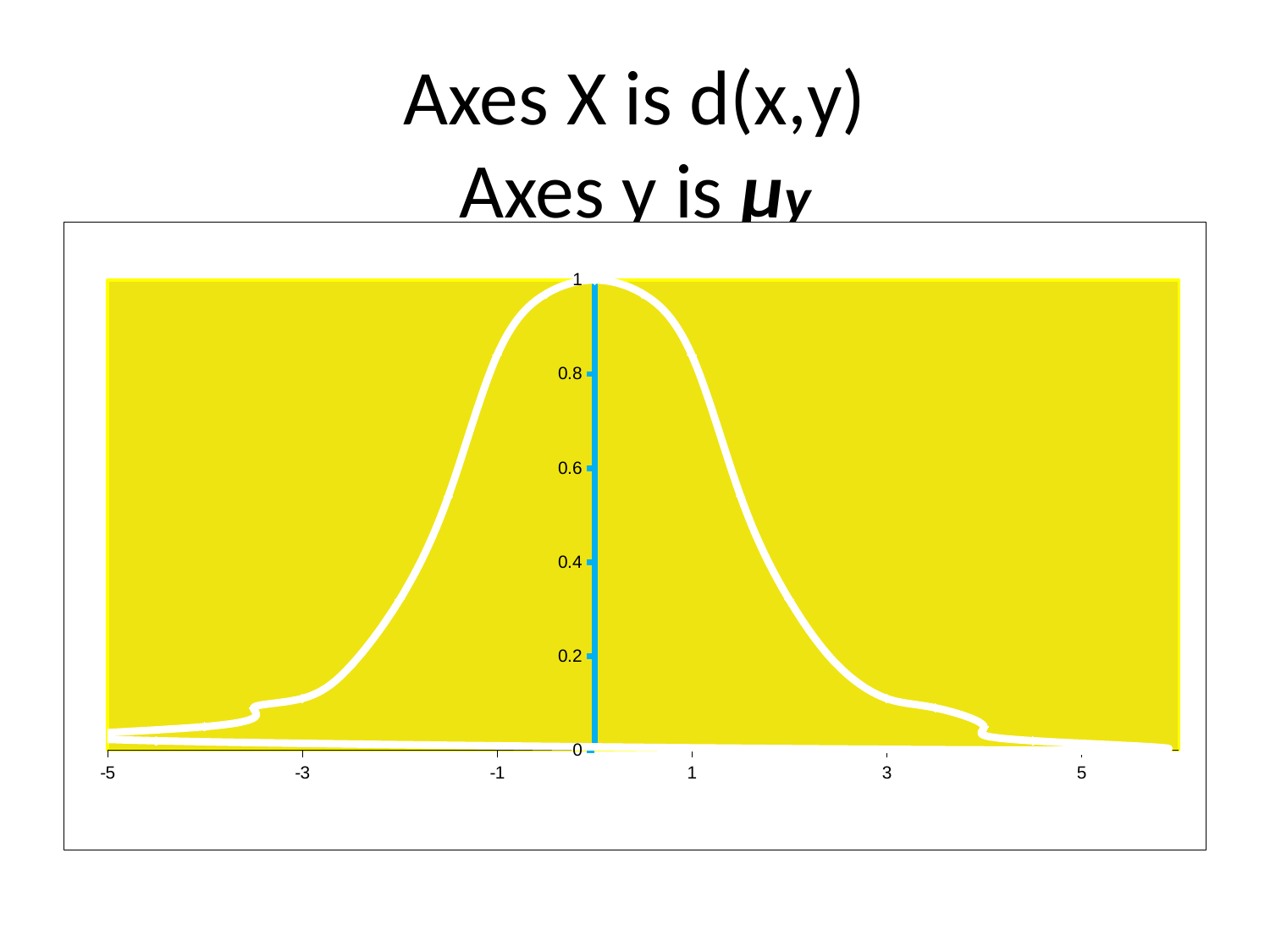
Is the value of the curve at x = 5 greater or less than 0.2? less What is the highest tick label shown on the y axis? 1 Does the curve rise or fall as x increases from -3 to -1? rise Is the value of the curve at x = 3 greater or less than 0.2? less Is the value of the curve at x = 0 greater or less than 0.8? greater Does the curve rise or fall as x increases from 1 to 3? fall What colour is the vertical line drawn at x = 0? blue Around which x-axis value does the white curve reach its highest point? 0 What kind of chart is shown on the slide? line chart